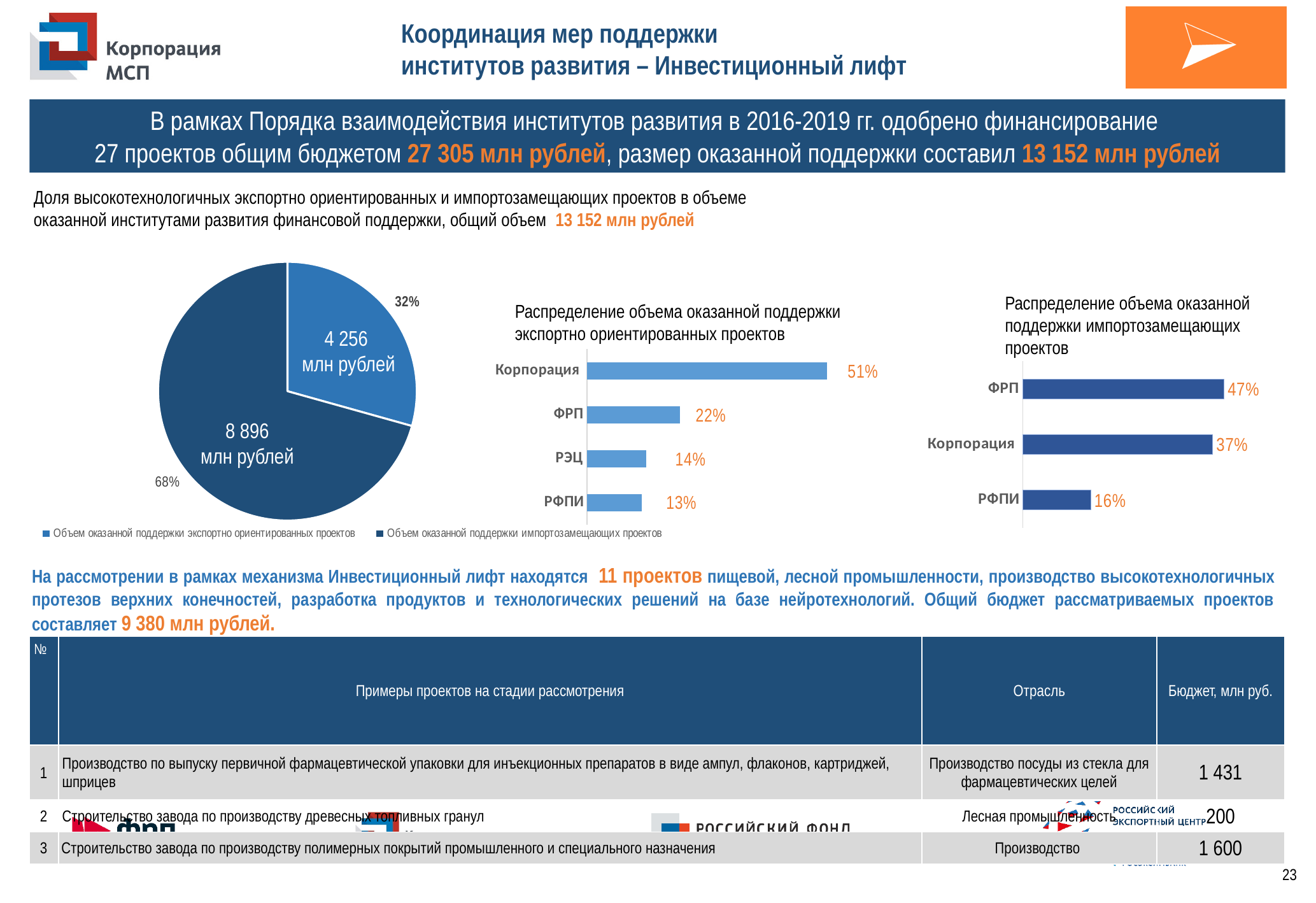
In the chart 'Распределение объема оказанной поддержки импортозамещающих проектов', which category has the highest value? ФРП In the chart 'Распределение объема оказанной поддержки экспортно ориентированных проектов', what is the value for Корпорация? 51% In the chart 'Распределение объема оказанной поддержки экспортно ориентированных проектов', which category has the lowest value? РФПИ In the chart 'Распределение объема оказанной поддержки экспортно ориентированных проектов', how many categories are shown? 4 On the pie chart on the left, what share of the pie is the volume of support for import-substituting projects (Объем оказанной поддержки импортозамещающих проектов)? 68% In the chart 'Распределение объема оказанной поддержки экспортно ориентированных проектов', what is the difference between the values for Корпорация and ФРП? 29% In the chart 'Распределение объема оказанной поддержки импортозамещающих проектов', what is the difference between the values for ФРП and Корпорация? 10% In the chart 'Распределение объема оказанной поддержки импортозамещающих проектов', what is the value for РФПИ? 16% On the pie chart on the left, what is the value for the volume of support for export-oriented projects (Объем оказанной поддержки экспортно ориентированных проектов)? 4 256 млн рублей What kind of chart is 'Распределение объема оказанной поддержки импортозамещающих проектов'? Bar chart In the chart 'Распределение объема оказанной поддержки импортозамещающих проектов', which is larger: the value for Корпорация or the value for РФПИ? Корпорация On the pie chart on the left, how many series does the legend list? 2